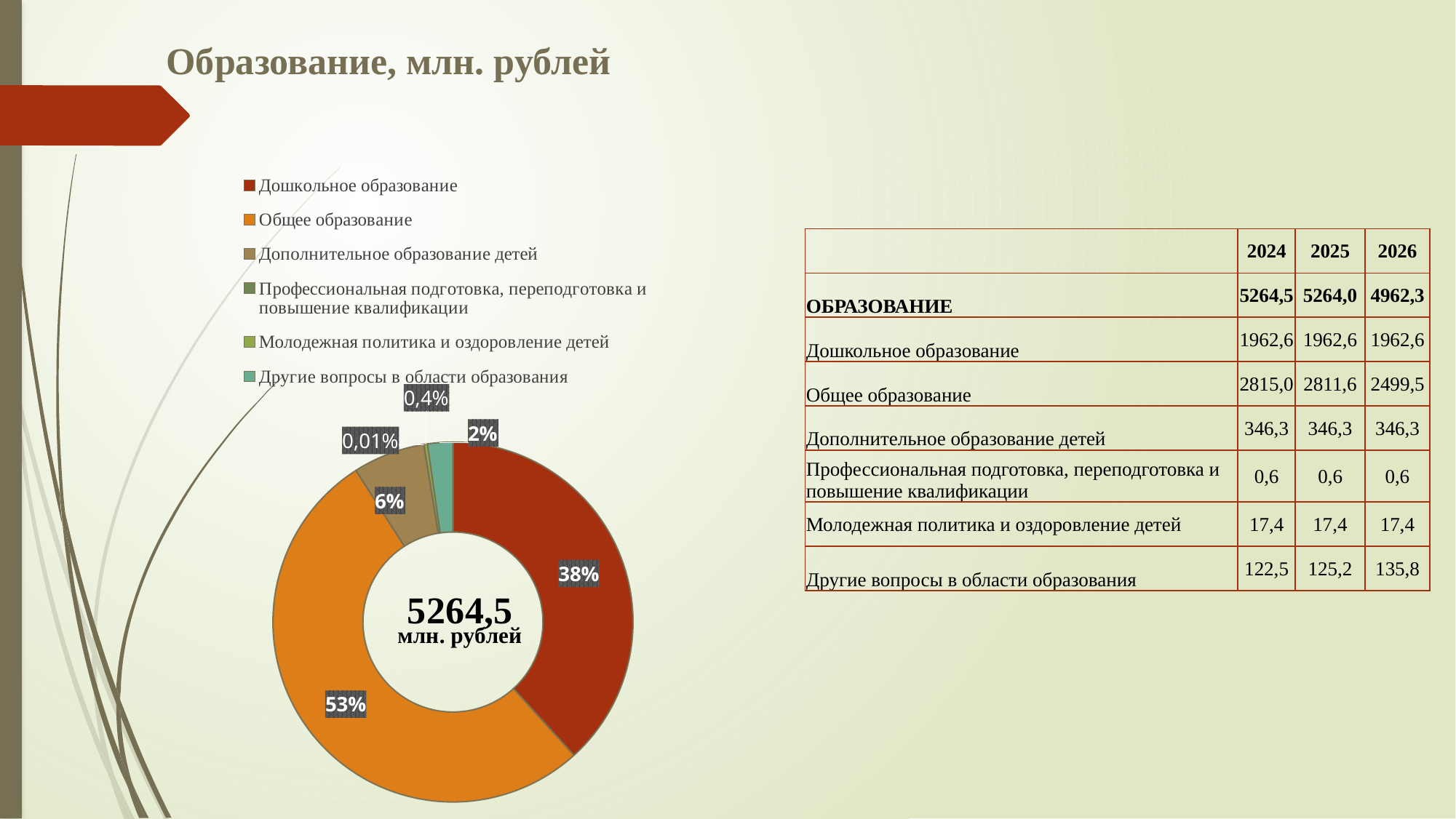
Which category has the largest slice in the doughnut chart? Общее образование Which category has the smallest slice in the doughnut chart? Профессиональная подготовка, переподготовка и повышение квалификации What share of the doughnut chart does Другие вопросы в области образования take? 2% How many categories does the legend of the doughnut chart list? 6 What share of the doughnut chart does Профессиональная подготовка, переподготовка и повышение квалификации take? 0,01% What share of the doughnut chart does Дополнительное образование детей take? 6% What kind of chart is shown on the slide? Doughnut (pie) chart Which slice is larger in the doughnut chart: Дошкольное образование or Дополнительное образование детей? Дошкольное образование What total value is printed in the centre of the doughnut chart? 5264,5 млн. рублей